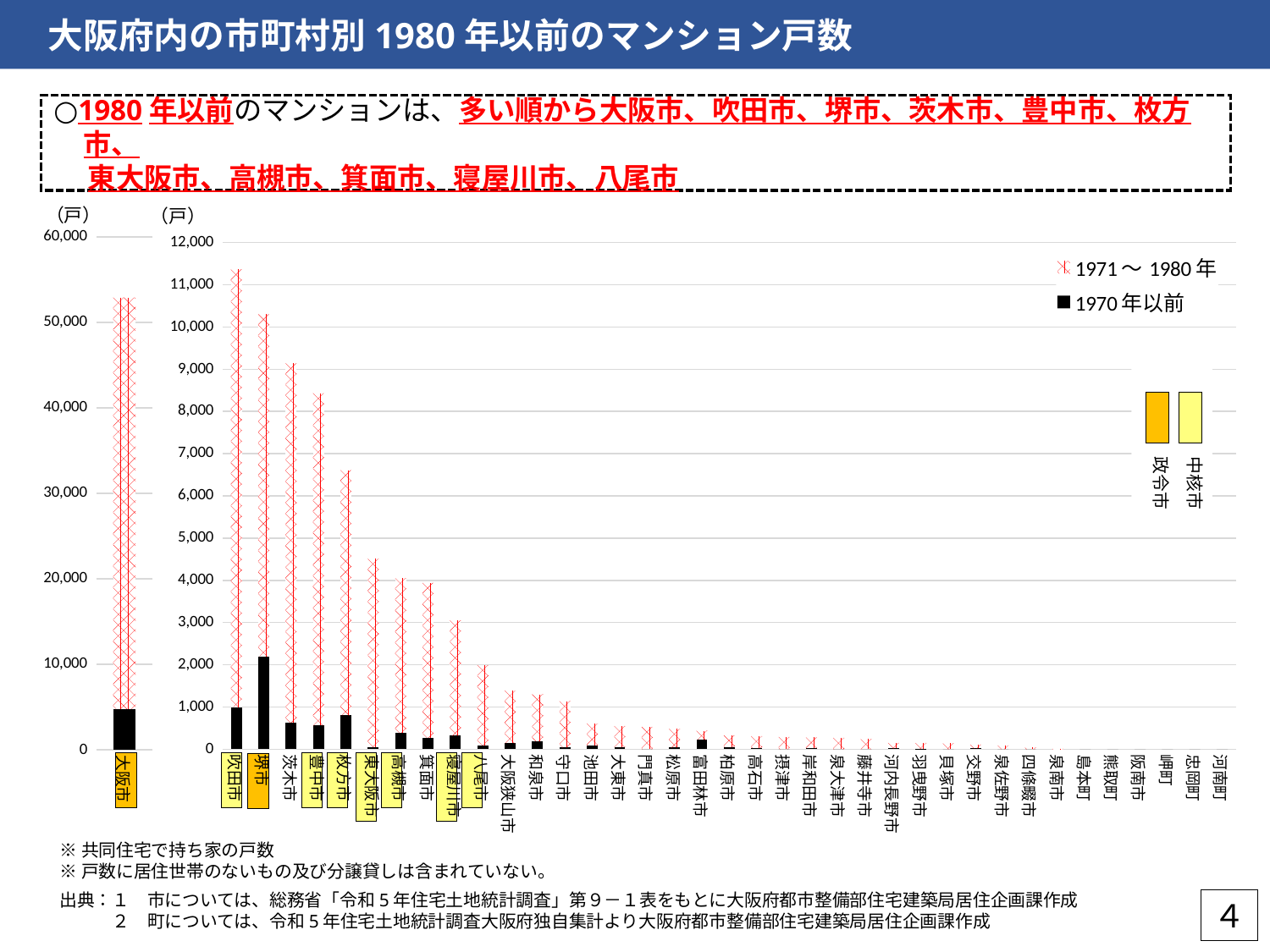
In the left-hand chart (axis up to 60,000), is the total value for 大阪市 greater or less than 50,000? greater In the right-hand chart, is the total value for 箕面市 greater or less than 3,000? greater In the right-hand chart, which has the larger 1970年以前 (black) portion, 堺市 or 吹田市? 堺市 In the right-hand chart, do the total values rise or fall moving from left to right along the x axis? fall In the right-hand chart (axis up to 12,000), which municipality has the highest total number of units? 吹田市 In the right-hand chart, which has the larger total, 寝屋川市 or 八尾市? 寝屋川市 What kind of chart is used on this slide to show the number of condominium units by municipality? bar chart In the right-hand chart, is the total value for 枚方市 greater or less than 7,000? less In the right-hand chart, which has the larger total, 茨木市 or 豊中市? 茨木市 How many series does the legend list? 2